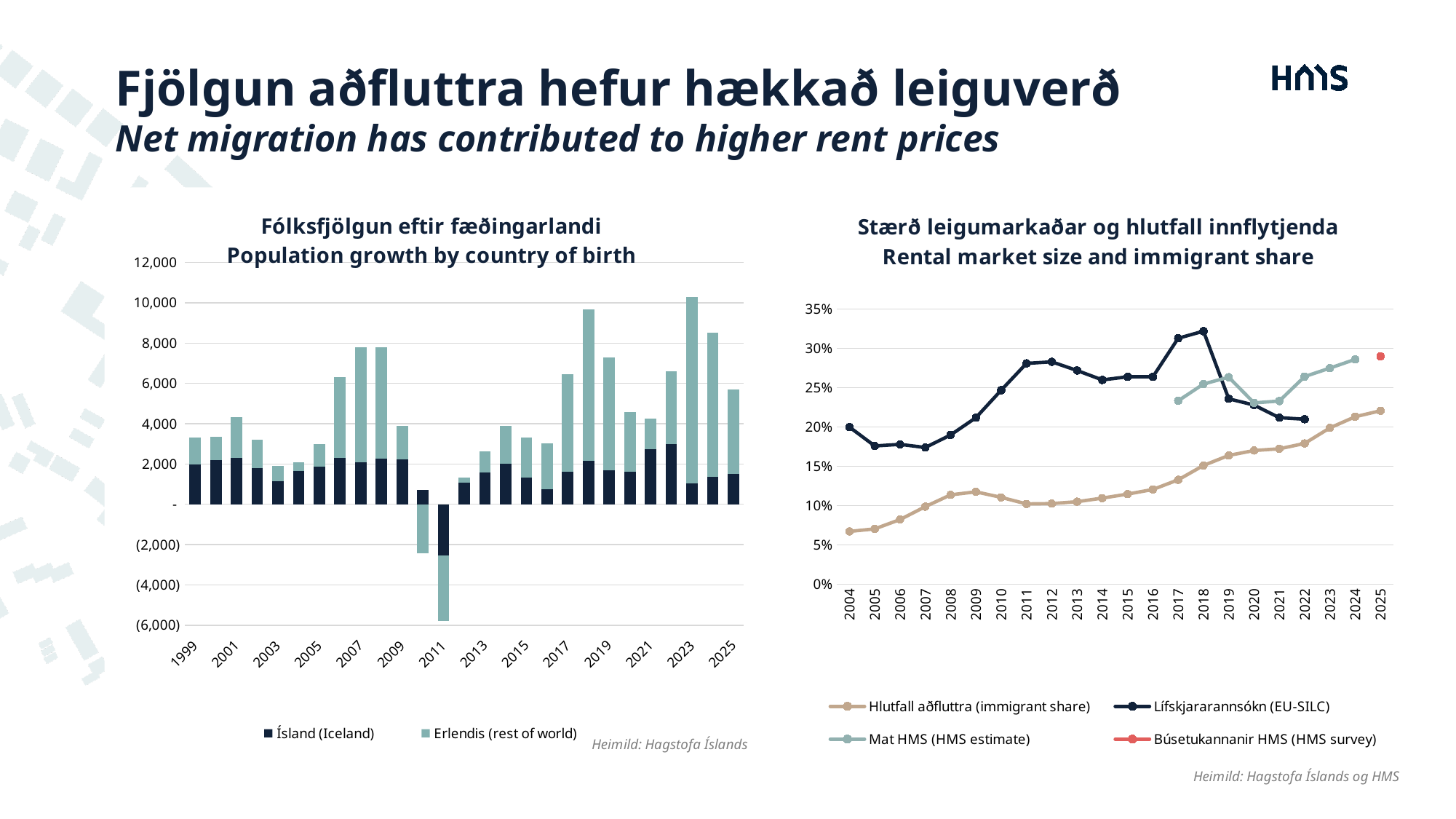
How many series does the legend of the left chart 'Population growth by country of birth' list? 2 In the right chart 'Rental market size and immigrant share', does the immigrant share (Hlutfall aðfluttra) generally rise or fall from 2004 to 2025? rise What kind of chart is the 'Population growth by country of birth' chart on the left? bar chart What kind of chart is the 'Rental market size and immigrant share' chart on the right? line chart How many series does the legend of the right chart 'Rental market size and immigrant share' list? 4 In the right chart 'Rental market size and immigrant share', is the immigrant share (Hlutfall aðfluttra) for 2025 greater or less than 20%? greater In the right chart 'Rental market size and immigrant share', in which year does the Lífskjararannsókn (EU-SILC) series reach its highest value? 2018 In the left chart 'Population growth by country of birth', which year has the lowest total population growth? 2011 In the right chart 'Rental market size and immigrant share', which is larger in 2022: the Mat HMS (HMS estimate) value or the Lífskjararannsókn (EU-SILC) value? Mat HMS (HMS estimate) In the left chart 'Population growth by country of birth', is the value for Erlendis (rest of world) in 2011 greater or less than 0? less In the left chart 'Population growth by country of birth', which year has the highest total population growth? 2023 In the left chart 'Population growth by country of birth', is the total value for 2018 greater or less than 8,000? greater